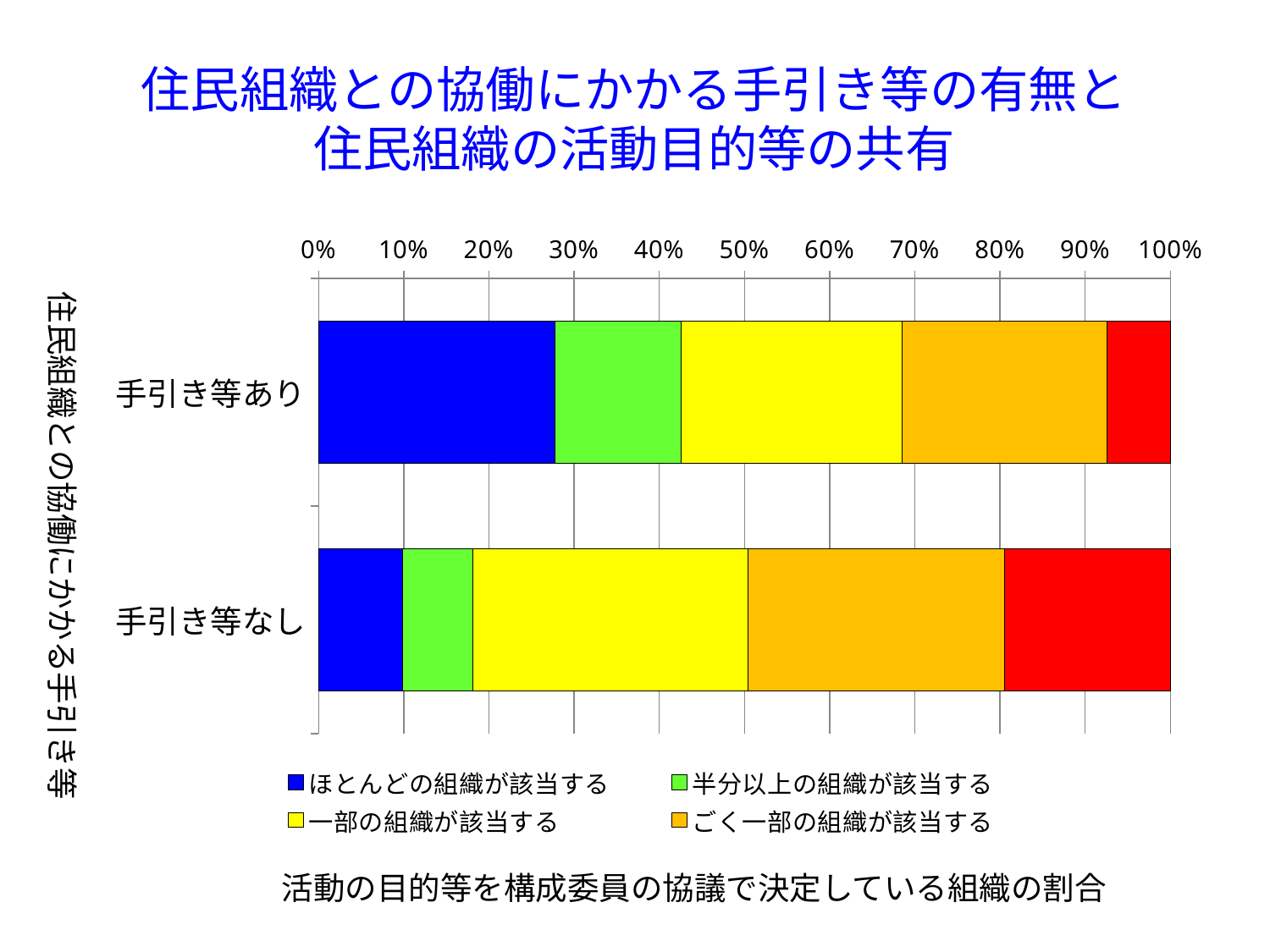
Which category has the larger blue (ほとんどの組織が該当する) segment, 手引き等あり or 手引き等なし? 手引き等あり Is the value of the blue (ほとんどの組織が該当する) segment for 手引き等なし greater or less than 20%? less Which category has the larger red segment at the right end of the bar, 手引き等あり or 手引き等なし? 手引き等なし Which category has the larger green (半分以上の組織が該当する) segment, 手引き等あり or 手引き等なし? 手引き等あり Is the value of the red segment for 手引き等あり greater or less than 10%? less Is the value of the blue (ほとんどの組織が該当する) segment for 手引き等あり greater or less than 20%? greater Which colour represents ほとんどの組織が該当する in the legend? Blue How many series does the chart's legend list? 4 What is the title of the slide's chart? 住民組織との協働にかかる手引き等の有無と住民組織の活動目的等の共有 What kind of chart is shown on the slide? Stacked bar chart How many categories are plotted on the vertical axis of the chart? 2